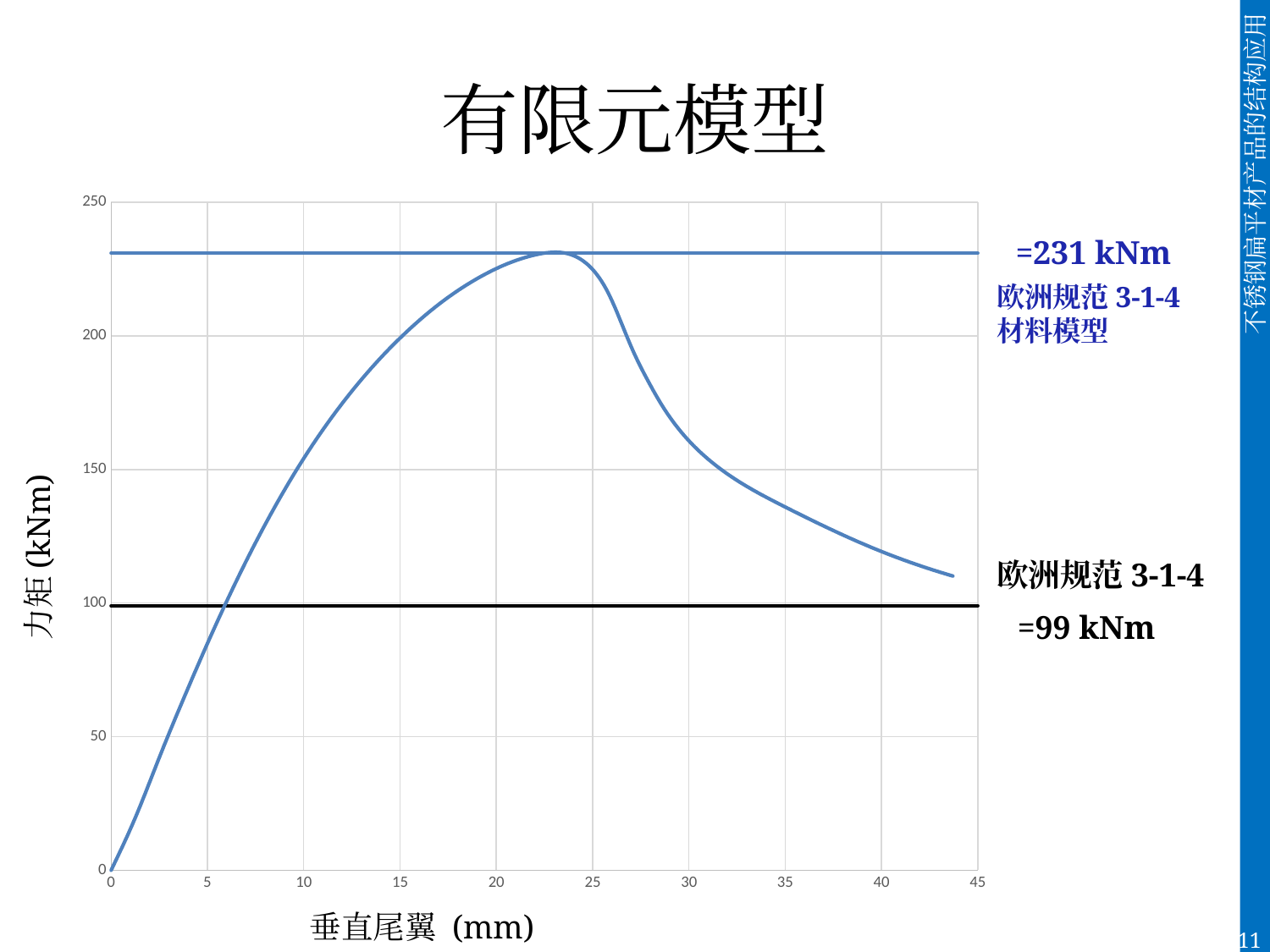
Does the curve rise or fall between 25 mm and 45 mm on the x axis? fall Is the value of the curve at 5 mm greater or less than 100? less What is the title of the vertical axis of the chart? 力矩 (kNm) Which horizontal reference line is higher, the blue one or the black one? the blue one (231 kNm) What is the title of the horizontal axis of the chart? 垂直尾翼 (mm) What value is labelled for the black horizontal line (欧洲规范 3-1-4)? 99 kNm What kind of chart is shown on the slide? line chart Is the value of the curve at 20 mm greater or less than 200? greater What is the difference between the 231 kNm line and the 99 kNm line? 132 kNm Does the curve rise or fall between 0 mm and 20 mm on the x axis? rise Is the value of the curve at 35 mm greater or less than 150? less What value is labelled for the blue horizontal line (欧洲规范 3-1-4 材料模型)? 231 kNm